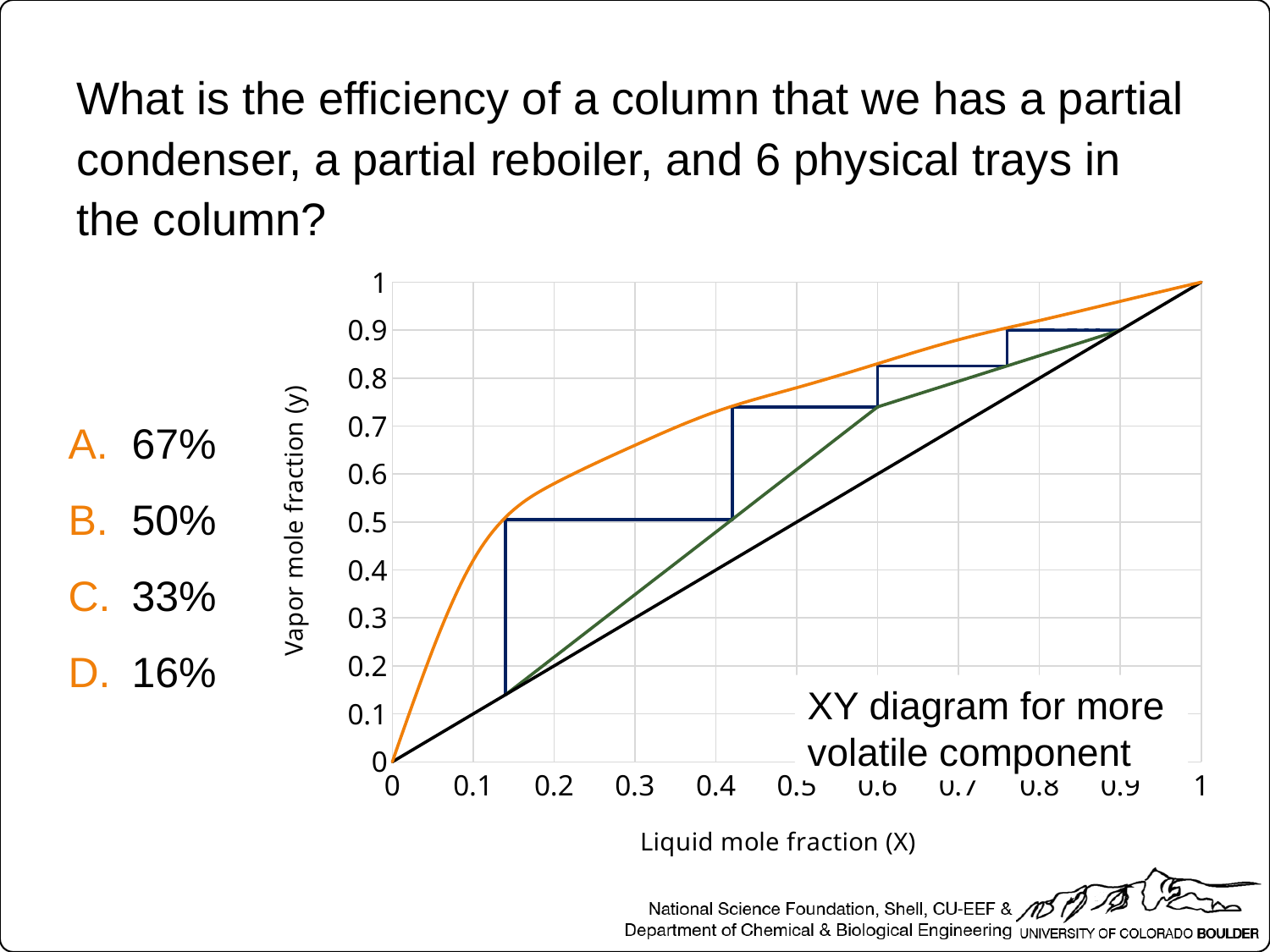
What is the label of the x axis of the chart? Liquid mole fraction (X) At a liquid mole fraction of 0.5, which line has the larger vapor mole fraction, the orange curve or the black diagonal line? the orange curve What is the vapor mole fraction of the black diagonal line at a liquid mole fraction of 1? 1 Does the orange equilibrium curve rise or fall as the liquid mole fraction increases from 0 to 1? rise What is the highest value shown on the y axis of the chart? 1 Is the value of the orange curve at a liquid mole fraction of 0.5 greater or less than 0.7? greater Is the value of the orange curve at a liquid mole fraction of 0.2 greater or less than 0.5? greater How many stair steps does the dark blue stepped line draw between the equilibrium curve and the operating lines? 4 What is the title of the chart? XY diagram for more volatile component Is the value of the orange curve at a liquid mole fraction of 0.8 greater or less than 0.8? greater What kind of chart is shown on the slide? line chart What is the vapor mole fraction of the black diagonal line at a liquid mole fraction of 0? 0